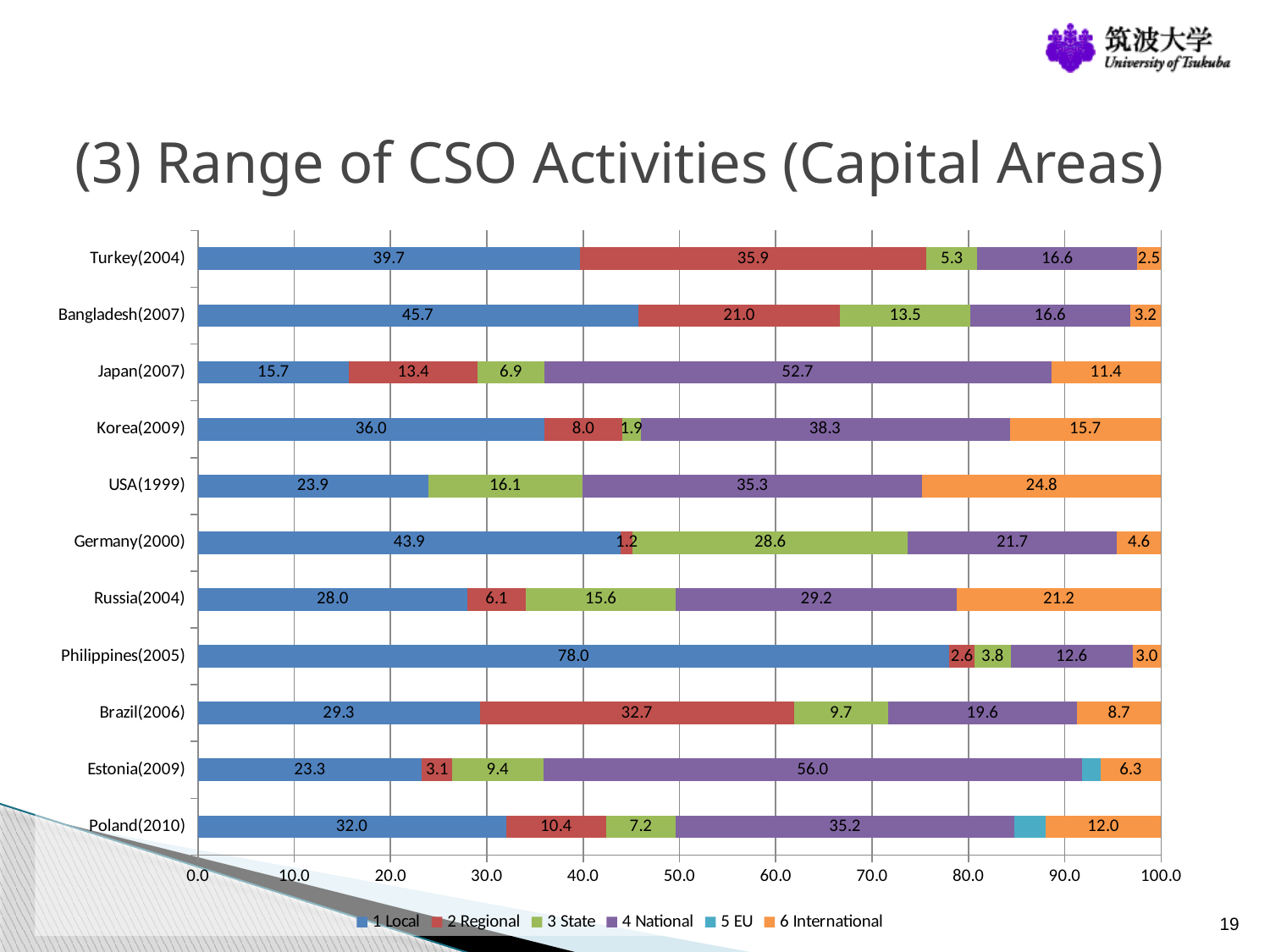
Which country has the highest '1 Local' value? Philippines(2005) What is the value of the '1 Local' segment for Philippines(2005)? 78.0 How many countries are listed on the vertical axis of the chart? 11 How many series does the legend list? 6 Which country has the lowest '1 Local' value? Japan(2007) Which series is shown in orange in the legend? 6 International What is the difference between the '2 Regional' values for Turkey(2004) and Bangladesh(2007)? 14.9 What kind of chart is shown on the slide? Stacked bar chart What is the value of the '4 National' segment for Japan(2007)? 52.7 Which country has the highest '6 International' value? USA(1999) What is the value of the '6 International' segment for USA(1999)? 24.8 Which is larger, the '4 National' value for Estonia(2009) or for Japan(2007)? Estonia(2009)